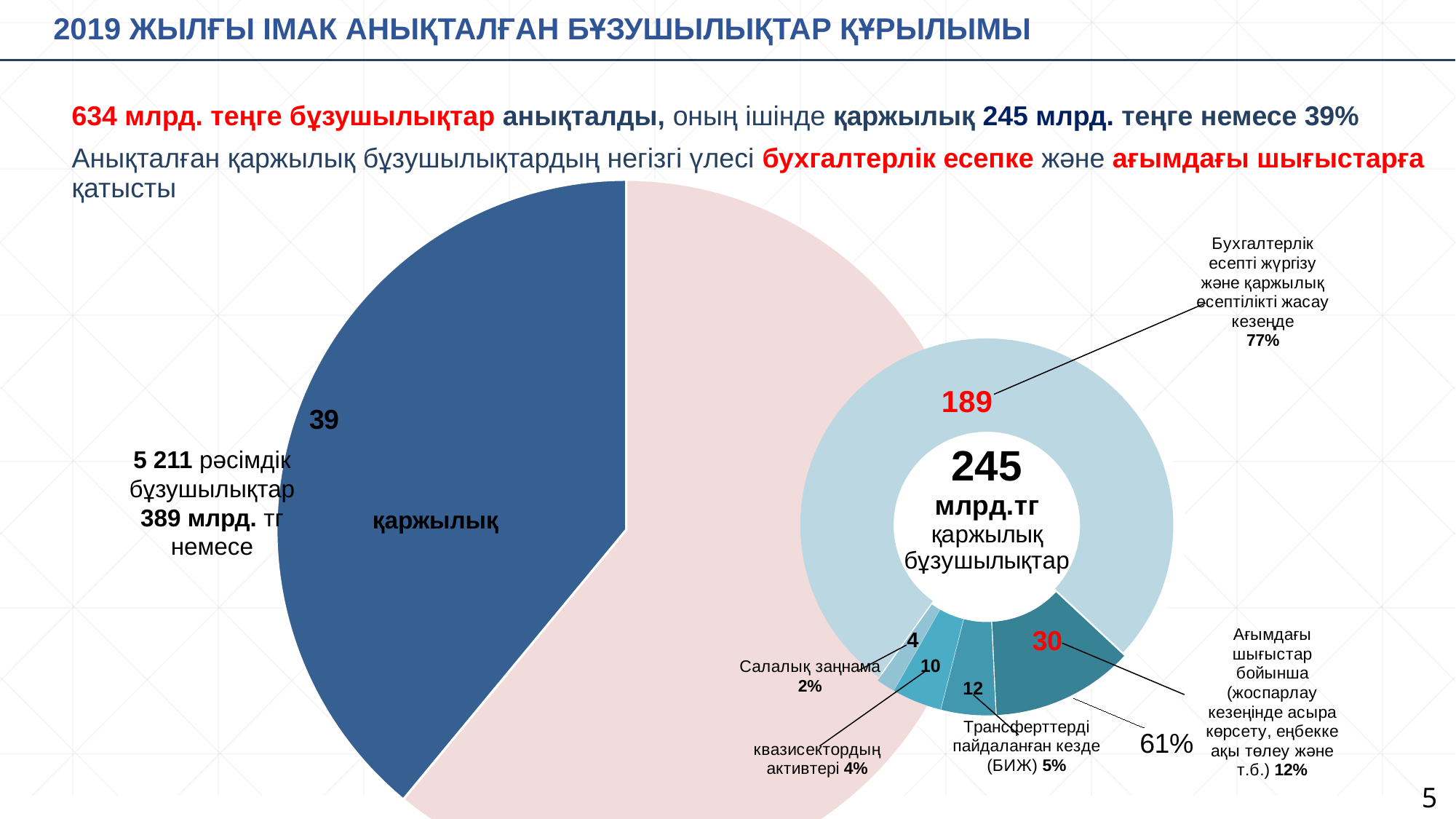
In the large pie chart on the left, what value is labelled on the 'қаржылық' slice? 39 In the donut chart on the right, what value is shown for the segment 'Бухгалтерлік есепті жүргізу және қаржылық есептілікті жасау кезеңде'? 189 In the donut chart on the right, what share is shown for the 'Бухгалтерлік есепті жүргізу және қаржылық есептілікті жасау кезеңде' segment? 77% How many segments does the donut chart on the right have? 5 In the donut chart on the right, what value is shown for the segment 'Ағымдағы шығыстар бойынша'? 30 In the donut chart on the right, which segment has the smallest value? Салалық заңнама In the donut chart on the right, what value is shown for 'Трансферттерді пайдаланған кезде (БИЖ)'? 12 In the donut chart on the right, what is the difference between the 'Бухгалтерлік есепті жүргізу' segment (189) and the 'Ағымдағы шығыстар' segment (30)? 159 In the donut chart on the right, which segment has the largest value? Бухгалтерлік есепті жүргізу және қаржылық есептілікті жасау кезеңде In the donut chart on the right, what value is shown for 'Салалық заңнама'? 4 What kind of chart is the chart on the right of the slide (with 245 млрд.тг in the centre)? pie chart (donut) In the donut chart on the right, what value is shown for 'квазисектордың активтері'? 10